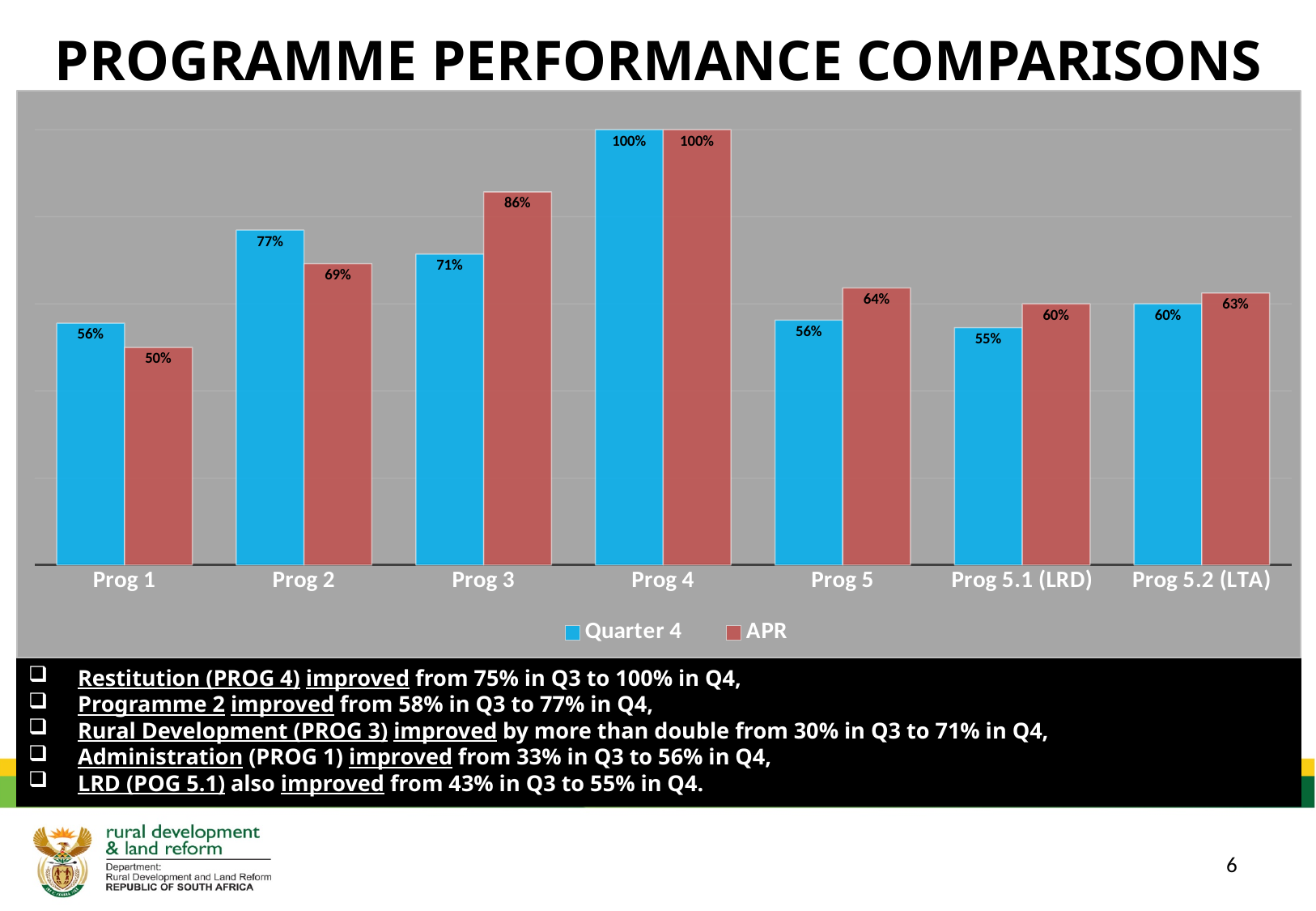
How many programmes are shown on the x axis? 7 Which programme has the lowest APR value? Prog 1 What kind of chart is shown on the slide? Bar chart Which series is shown in red in the legend? APR What is the Quarter 4 value for Prog 3? 71% What is the APR value for Prog 2? 69% What is the APR value for Prog 5.1 (LRD)? 60% What is the difference between the Quarter 4 values for Prog 2 and Prog 1? 21% Which programme has the highest Quarter 4 value? Prog 4 Which is larger for Prog 2, the Quarter 4 value or the APR value? Quarter 4 How many series does the legend list? 2 What is the difference between the APR and Quarter 4 values for Prog 3? 15%